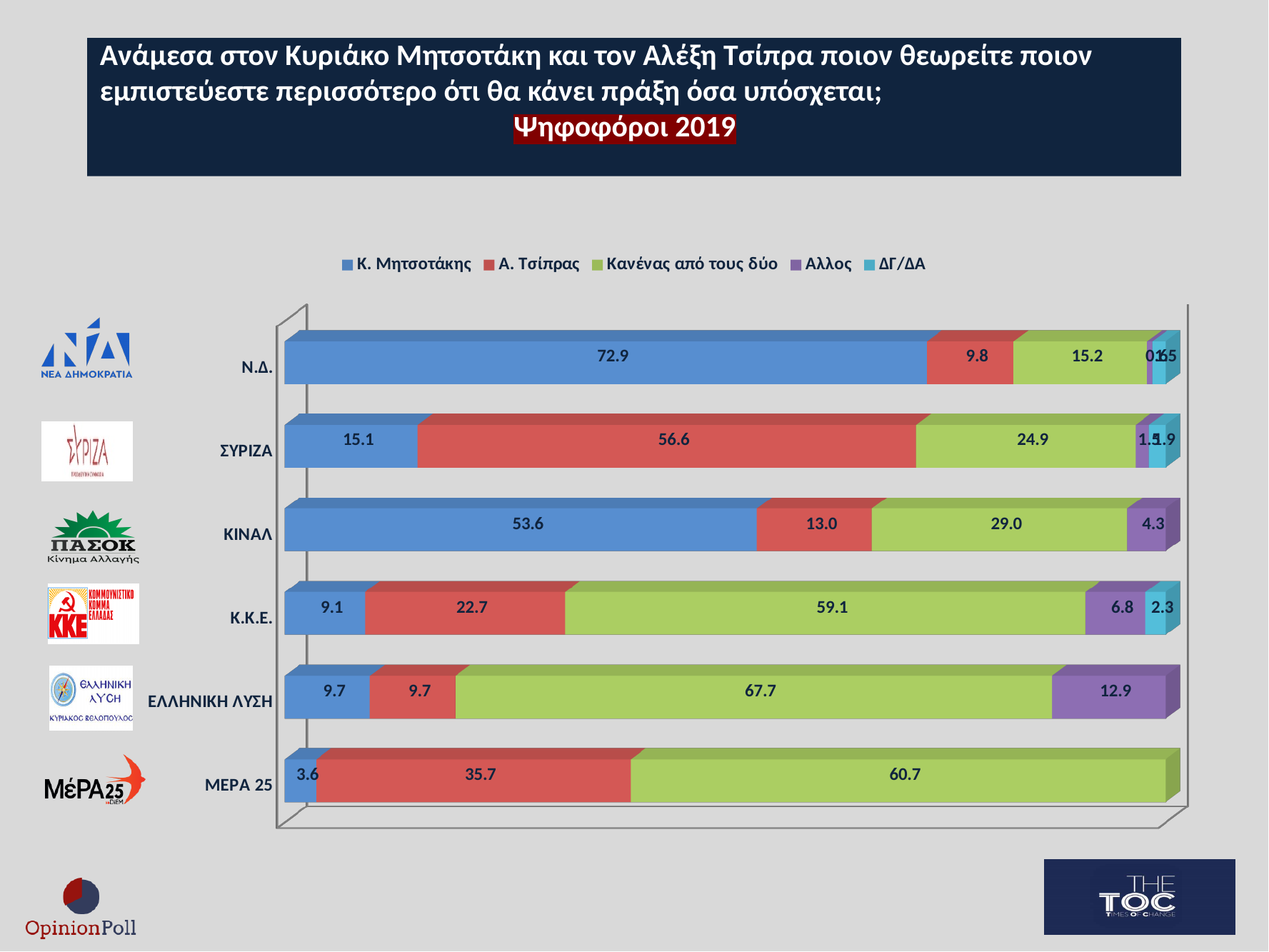
What kind of chart is shown on the slide? Stacked bar chart How many party categories are shown on the chart? 6 Which party's voters have the highest value for Κ. Μητσοτάκης? Ν.Δ. What is the value for Άλλος among Κ.Κ.Ε. voters? 6.8 What is the value for Α. Τσίπρας among ΣΥΡΙΖΑ voters? 56.6 How many series does the legend list? 5 What is the difference between the Κανένας από τους δύο value for ΜΕΡΑ 25 voters and for ΚΙΝΑΛ voters? 31.7 What is the value for Κανένας από τους δύο among ΕΛΛΗΝΙΚΗ ΛΥΣΗ voters? 67.7 Which party's voters have the lowest value for Κ. Μητσοτάκης? ΜΕΡΑ 25 Which is larger: the Α. Τσίπρας value for Κ.Κ.Ε. voters or for ΚΙΝΑΛ voters? Κ.Κ.Ε. What is the value for Κ. Μητσοτάκης among Ν.Δ. voters? 72.9 Which legend entry is shown in green? Κανένας από τους δύο